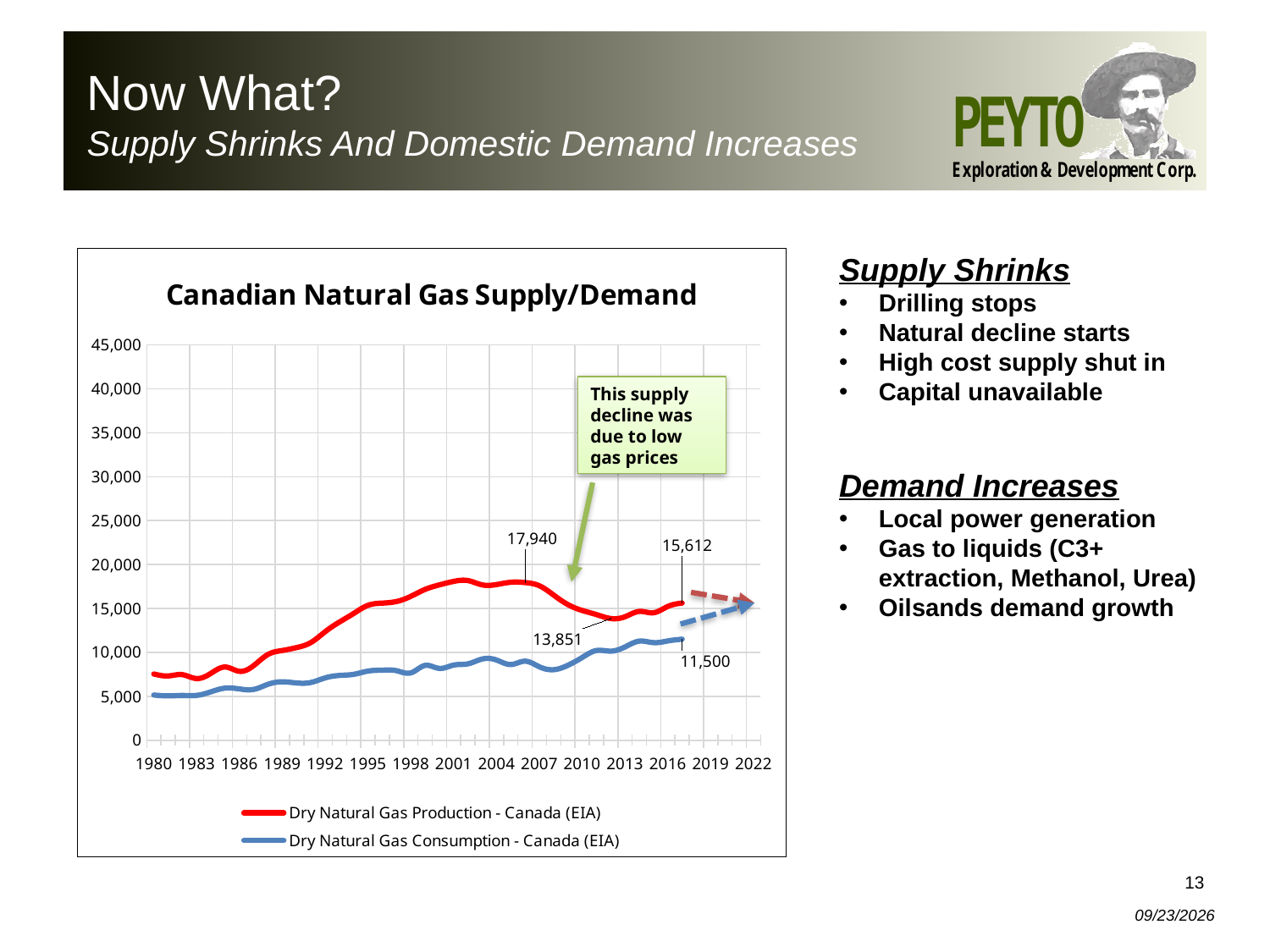
What colour is the Dry Natural Gas Production - Canada (EIA) line? red Is the Dry Natural Gas Production value in 1980 greater or less than 10,000? less What is the labelled low value on the Dry Natural Gas Production line after its decline, around 2012? 13,851 Does the Dry Natural Gas Consumption line generally rise or fall from 1980 to 2017? rise What is the difference between the labelled production value 15,612 and the labelled consumption value 11,500? 4,112 What is the peak value labelled on the Dry Natural Gas Production line? 17,940 What is the last labelled value on the Dry Natural Gas Production line, near 2017? 15,612 What type of chart is shown on the slide? line chart What is the value labelled on the Dry Natural Gas Consumption line, near 2017? 11,500 At the end of the plotted data, which is larger: Dry Natural Gas Production or Dry Natural Gas Consumption? Dry Natural Gas Production How many series does the legend of the Canadian Natural Gas Supply/Demand chart list? 2 What is the difference between the labelled production peak of 17,940 and the labelled low of 13,851? 4,089